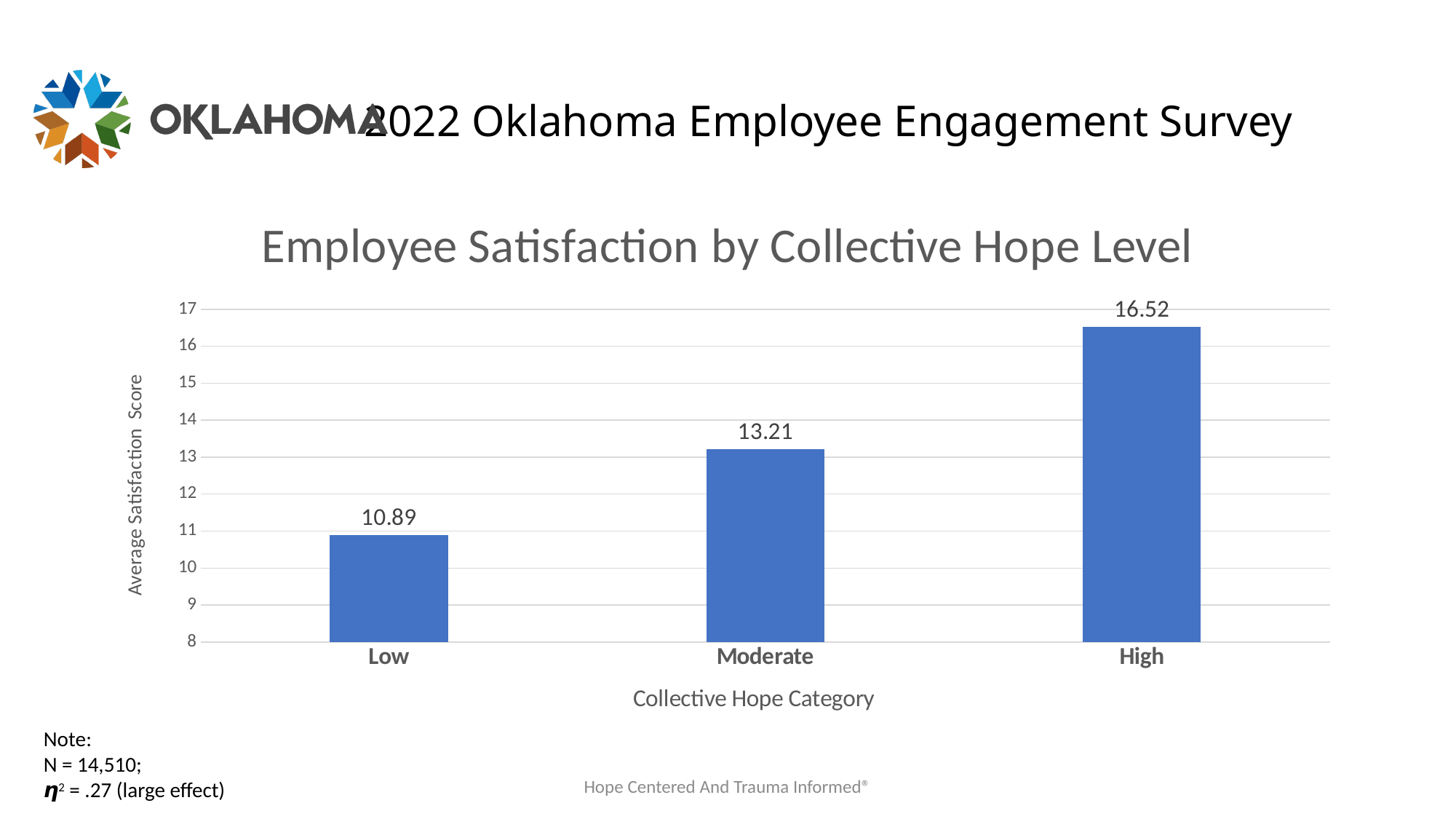
What kind of chart is shown on the slide? Bar chart What is the average satisfaction score for the High collective hope category? 16.52 How many collective hope categories are shown on the chart? 3 What is the difference between the average satisfaction scores for the Moderate and Low categories? 2.32 Which has a higher average satisfaction score, Moderate or High? High Is the average satisfaction score for the Moderate category greater or less than 13? greater Which collective hope category has the highest average satisfaction score? High What is the average satisfaction score for the Moderate collective hope category? 13.21 Which collective hope category has the lowest average satisfaction score? Low What is the difference between the average satisfaction scores for the High and Low categories? 5.63 Do the average satisfaction scores rise or fall from Low to High collective hope? Rise What is the average satisfaction score for the Low collective hope category? 10.89